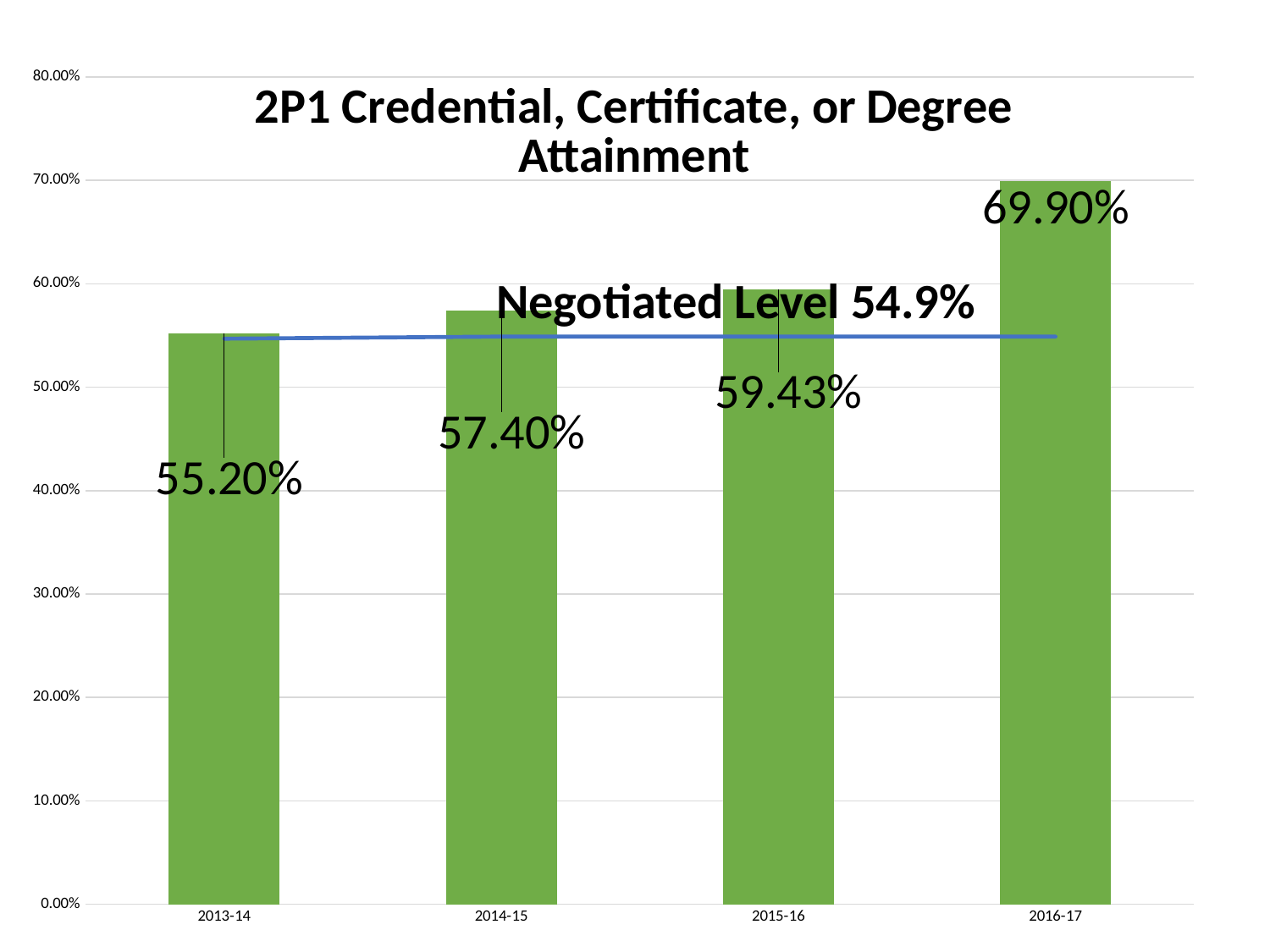
Do the values rise or fall from 2013-14 to 2016-17? Rise How many years are shown on the x axis? 4 What is the value for 2015-16? 59.43% Which year has the lowest value? 2013-14 What is the value for 2016-17? 69.90% Which year has the highest value? 2016-17 What kind of chart is this? Bar chart What is the Negotiated Level shown by the horizontal line? 54.9% What is the value for 2013-14? 55.20% What is the value for 2014-15? 57.40% What is the difference between the values for 2016-17 and 2013-14? 14.70% Which is larger, the value for 2014-15 or the value for 2015-16? 2015-16